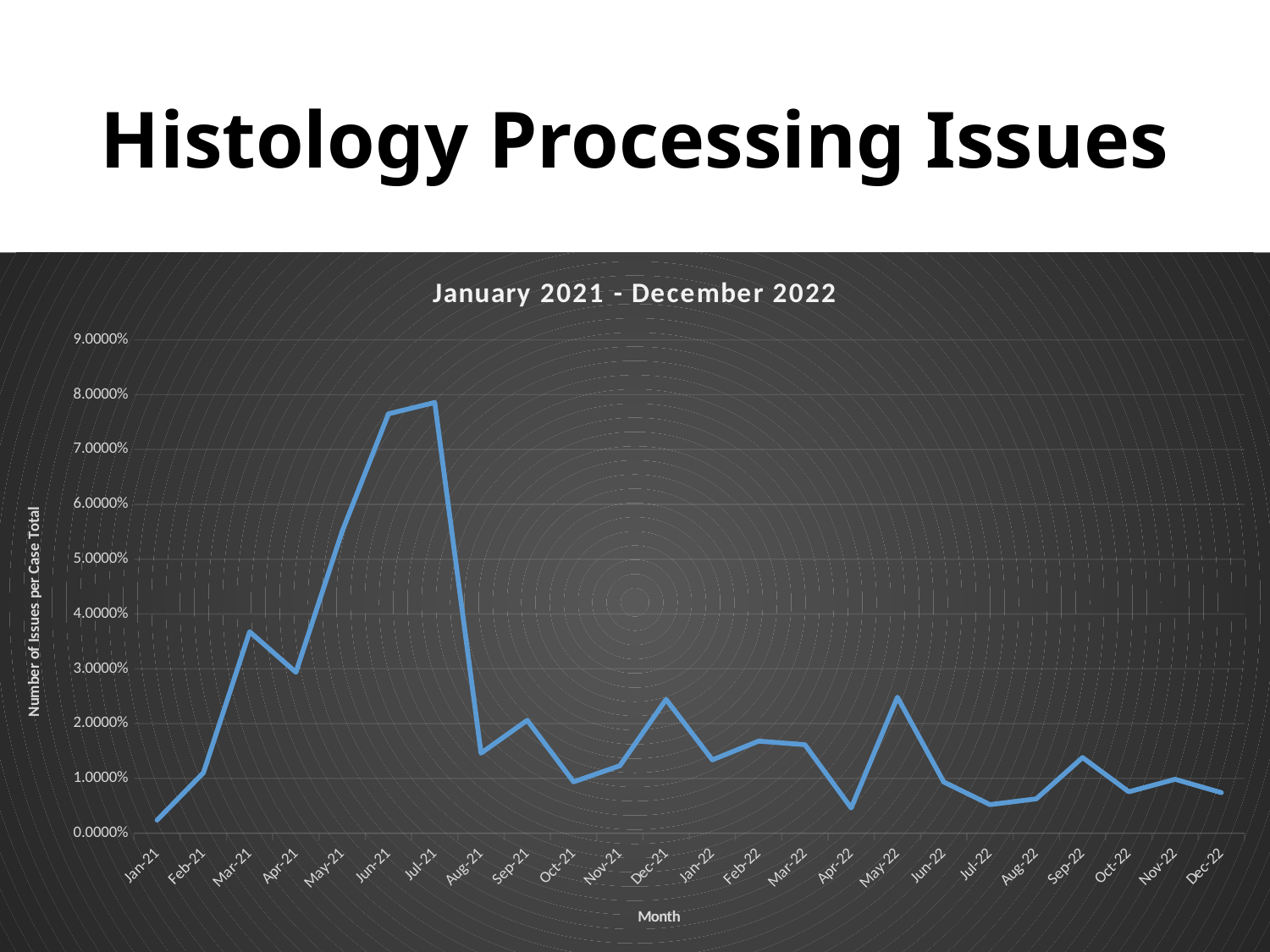
Does the value rise or fall from Jul-21 to Aug-21? Fall Which month has the lowest value? Jan-21 Is the value for Mar-21 greater or less than 3.0000%? greater How many months are plotted along the x axis? 24 Which is larger, the value for Mar-21 or the value for Apr-21? Mar-21 What is the title of the chart? January 2021 - December 2022 Which is larger, the value for May-22 or the value for Jun-22? May-22 Is the value for Apr-22 greater or less than 1.0000%? less Which month has the highest value? Jul-21 What is the label on the vertical axis of the chart? Number of Issues per Case Total Is the value for Jun-21 greater or less than 7.0000%? greater What kind of chart is shown on the slide? Line chart